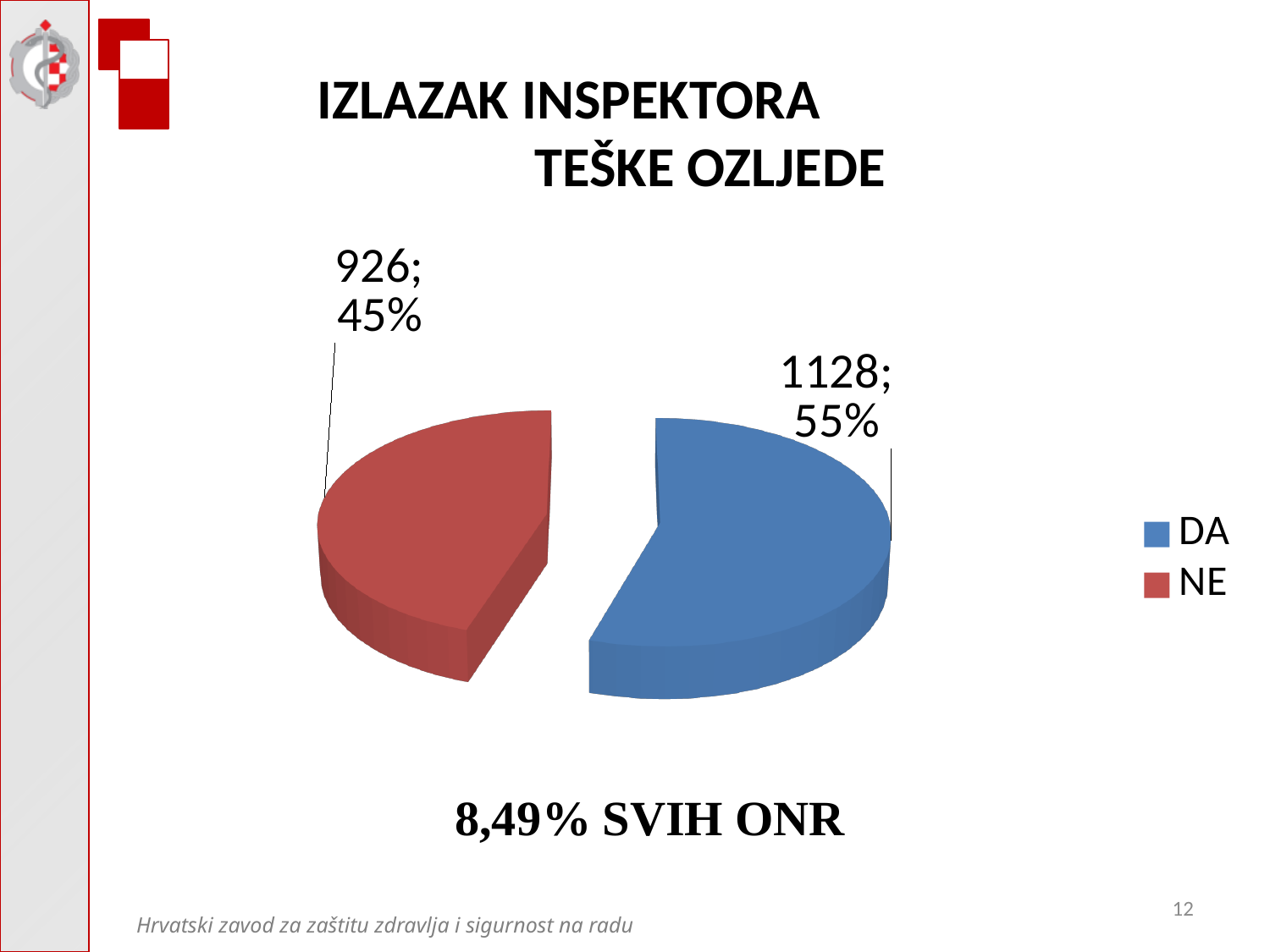
How many entries does the legend list? 2 What is the difference between the values for DA and NE? 202 What is the value for NE? 926 What share of the pie does NE represent? 45% What share of the pie does DA represent? 55% What colour is the DA slice? blue What is the value for DA? 1128 Which category has the largest slice? DA What kind of chart is shown on the slide? pie chart Which category has the smallest slice? NE Which is larger, the value for DA or the value for NE? DA How many slices does the pie chart have? 2